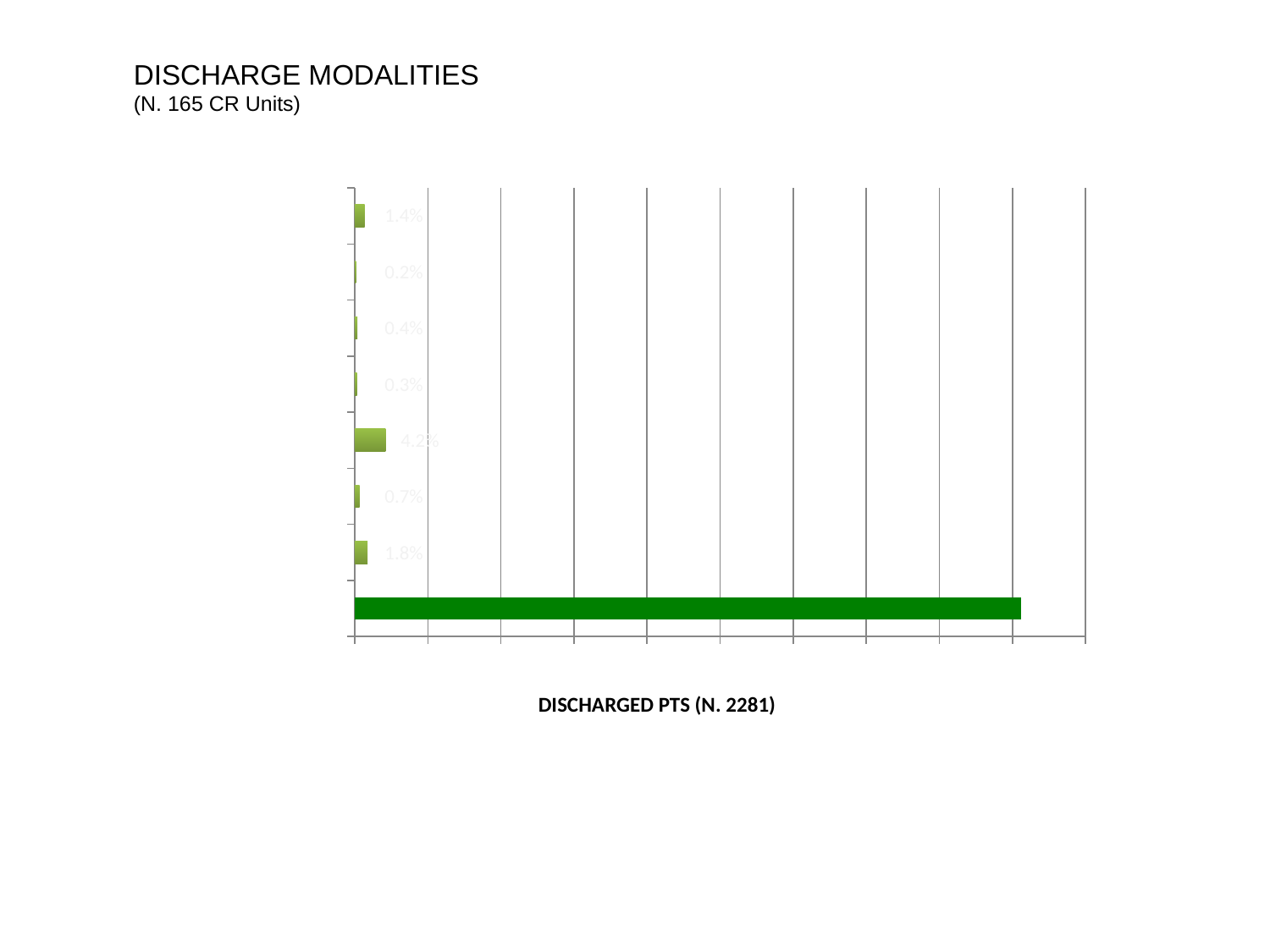
What is the value shown on the data label of the seventh bar from the top (the one just above the long dark green bar)? 1.8% Among the bars that have a printed data label, which value is the highest? 4.2% How many bars are plotted in the chart? 8 What is the value shown on the data label of the topmost bar? 1.4% What is the difference between the 4.2% bar and the 1.8% bar? 2.4% Among the bars that have a printed data label, which value is the lowest? 0.2% Which is larger: the value of the topmost bar or the value of the seventh bar from the top? the seventh bar from the top (1.8%) What text appears as the horizontal axis title below the chart? DISCHARGED PTS (N. 2281) What is the value shown on the data label of the second bar from the top? 0.2% What kind of chart is shown on the slide? bar chart What is the title of the slide above the chart? DISCHARGE MODALITIES (N. 165 CR Units) What is the value shown on the data label of the fifth bar from the top? 4.2%